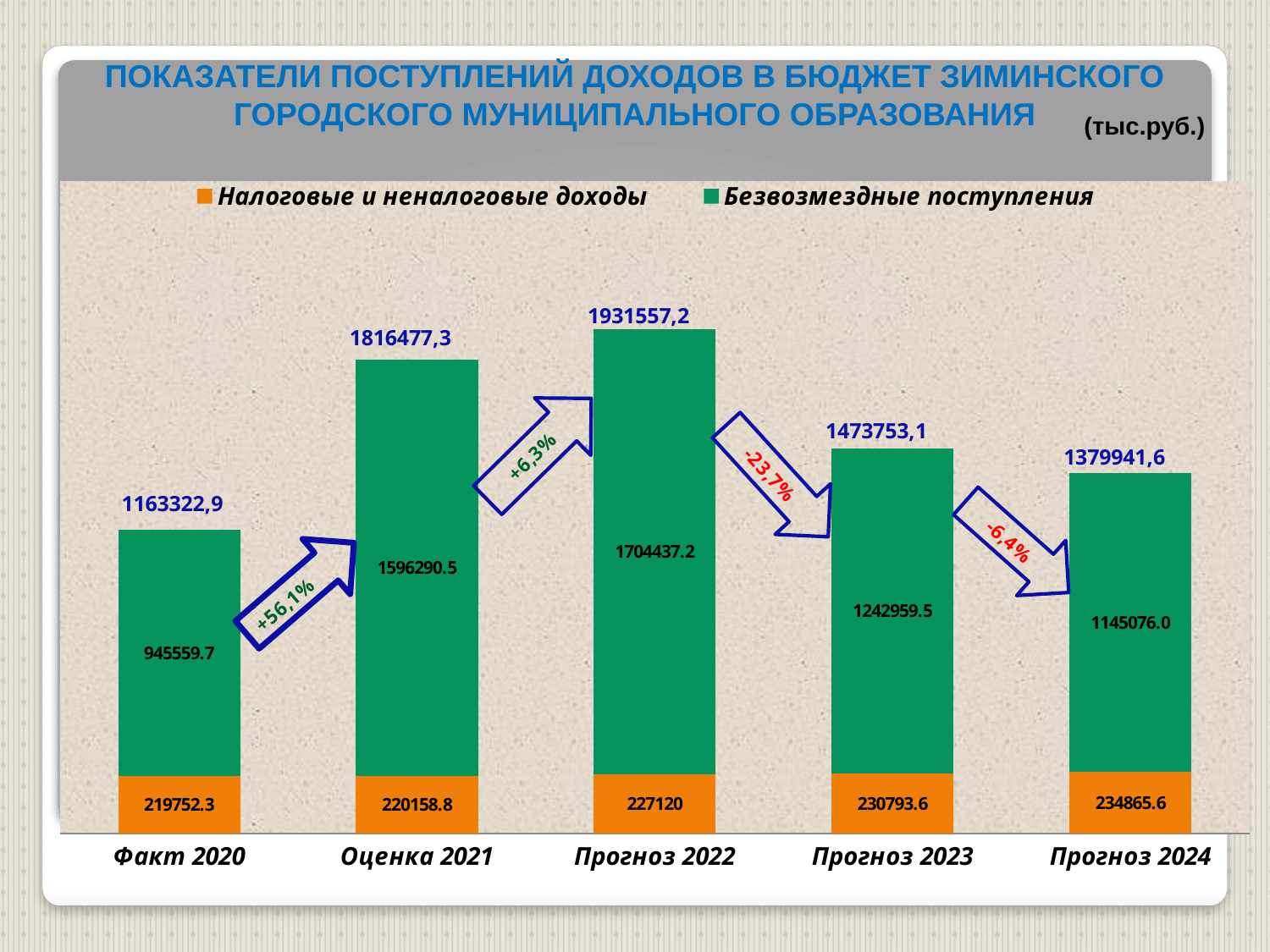
How many series does the legend list? 2 What is the value of Безвозмездные поступления for Оценка 2021? 1596290.5 How many categories are shown on the x axis? 5 What percentage change is shown on the arrow between Факт 2020 and Оценка 2021? +56,1% What unit is indicated in the top right of the chart title area? тыс.руб. What is the value of Налоговые и неналоговые доходы for Прогноз 2022? 227120 Which category has the highest total? Прогноз 2022 What type of chart is shown on the slide? Stacked bar chart Which category has the lowest value for Безвозмездные поступления? Факт 2020 What is the difference between Безвозмездные поступления for Прогноз 2022 and Оценка 2021? 108146.7 Which is larger: Безвозмездные поступления for Прогноз 2023 or for Прогноз 2024? Прогноз 2023 What is the total of the stacked bar for Прогноз 2023? 1473753,1